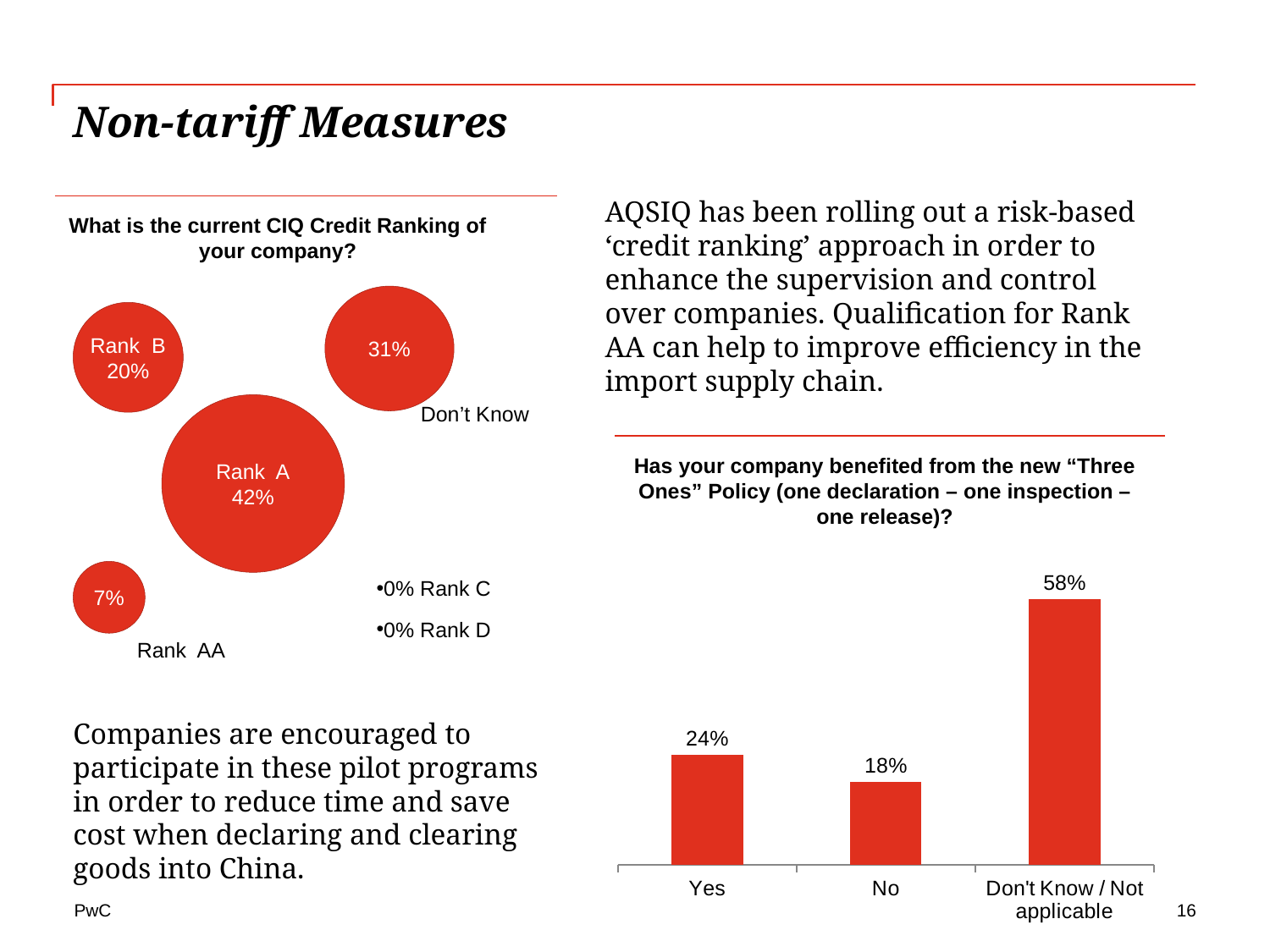
In the bar chart titled "Has your company benefited from the new 'Three Ones' Policy", how many categories are shown? 3 In the bar chart titled "Has your company benefited from the new 'Three Ones' Policy", what is the value for "No"? 18% What kind of chart is the chart titled "Has your company benefited from the new 'Three Ones' Policy"? Bar chart In the bar chart titled "Has your company benefited from the new 'Three Ones' Policy", what is the difference between the values for "Don't Know / Not applicable" and "Yes"? 34% In the bar chart titled "Has your company benefited from the new 'Three Ones' Policy", which category has the lowest value? No In the chart titled "What is the current CIQ Credit Ranking of your company?", what is the difference between Rank A and Rank B? 22% In the chart titled "What is the current CIQ Credit Ranking of your company?", what is the value for Rank A? 42% In the bar chart titled "Has your company benefited from the new 'Three Ones' Policy", which category has the highest value? Don't Know / Not applicable In the chart titled "What is the current CIQ Credit Ranking of your company?", what is the value for Don't Know? 31% In the chart titled "What is the current CIQ Credit Ranking of your company?", what is the value for Rank AA? 7% In the chart titled "What is the current CIQ Credit Ranking of your company?", which is larger, Rank B or Don't Know? Don't Know In the bar chart titled "Has your company benefited from the new 'Three Ones' Policy", what is the value for "Yes"? 24%